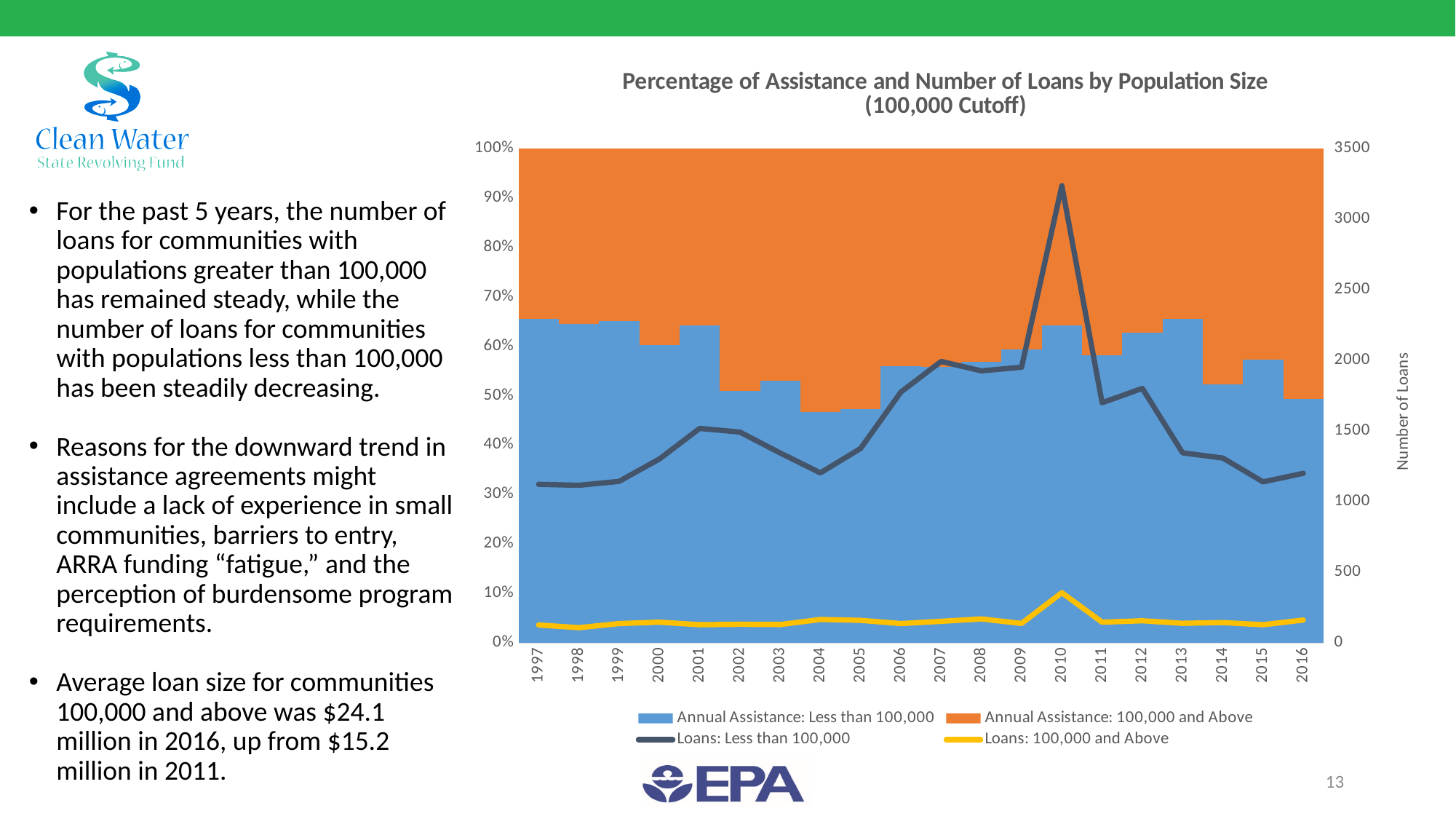
Is the share for Annual Assistance: Less than 100,000 in 2013 greater or less than 60%? greater In which year does the Loans: Less than 100,000 line reach its highest value? 2010 Is the value for Loans: Less than 100,000 in 2010 greater or less than 3000? greater Is the value for Loans: 100,000 and Above in 2010 greater or less than 500? less What is the title of the chart? Percentage of Assistance and Number of Loans by Population Size (100,000 Cutoff) Which colour represents Annual Assistance: 100,000 and Above in the chart? Orange How many series does the chart legend list? 4 Does the Loans: Less than 100,000 line rise or fall from 2012 to 2015? fall How many years are shown on the x axis of the chart? 20 In which year does the Loans: 100,000 and Above line reach its highest value? 2010 Which year has the larger share for Annual Assistance: Less than 100,000, 2001 or 2002? 2001